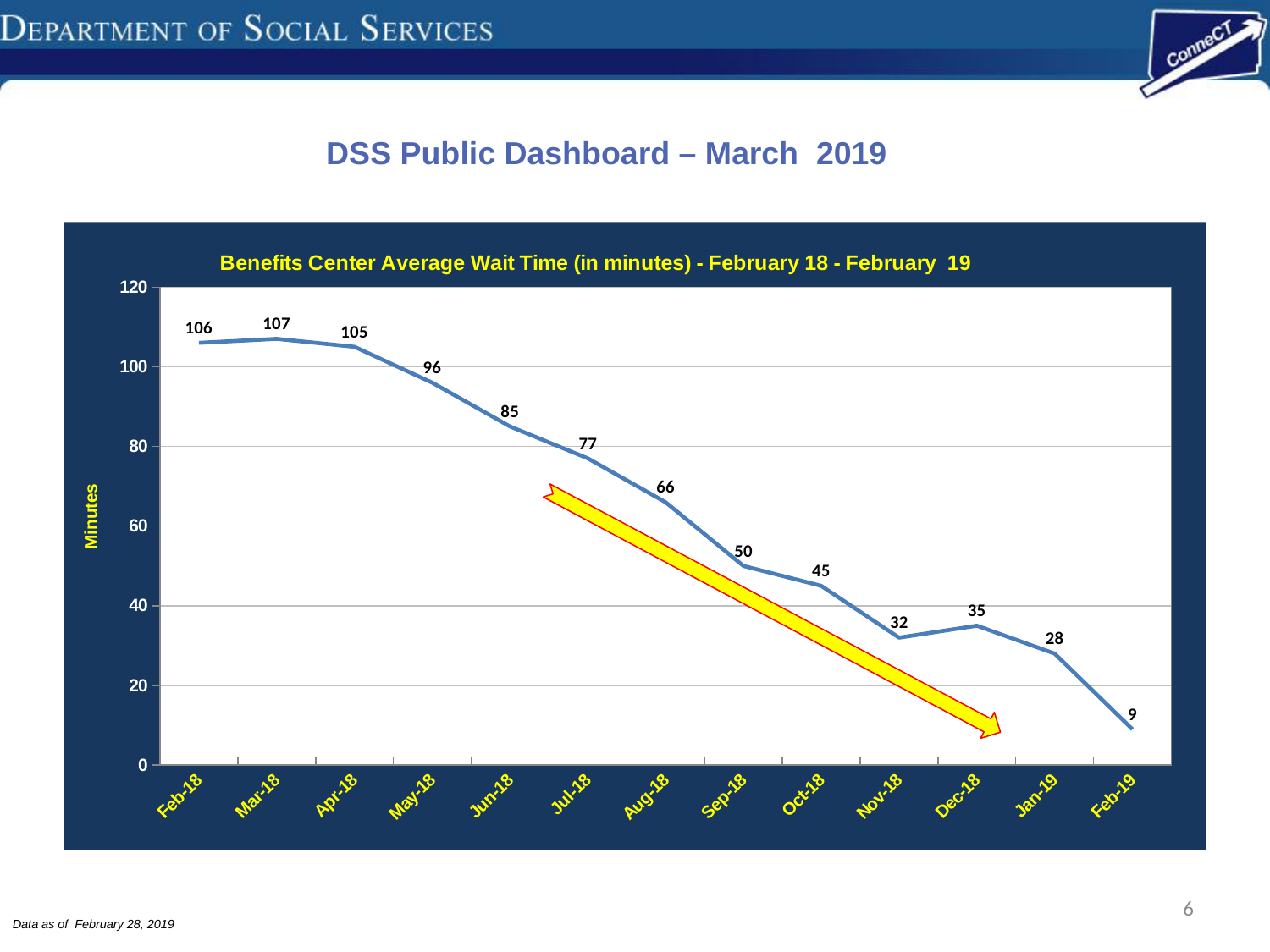
What is the difference in average wait time between Feb-18 and Feb-19? 97 What is the average wait time for Sep-18? 50 What is the title of the chart? Benefits Center Average Wait Time (in minutes) - February 18 - February 19 What is the label on the vertical axis of the chart? Minutes Which month has a higher average wait time, Nov-18 or Dec-18? Dec-18 How many months are plotted on the chart? 13 What kind of chart is shown on the slide? Line chart What is the average wait time for Feb-19? 9 Do the average wait times generally rise or fall from Feb-18 to Feb-19? Fall Which month has the highest average wait time? Mar-18 Which month has the lowest average wait time? Feb-19 What is the average wait time for Feb-18? 106